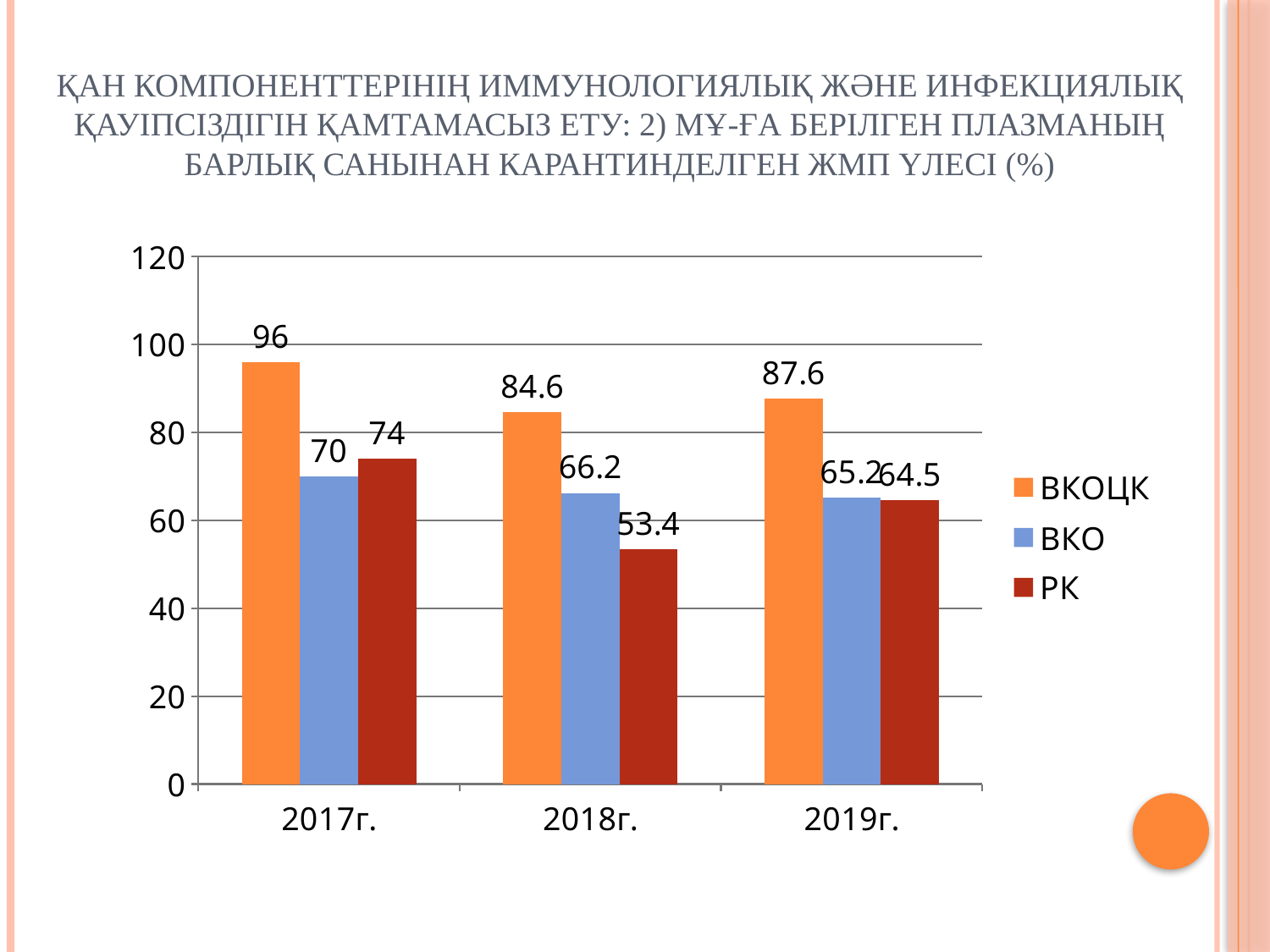
How many years are shown on the x axis? 3 What is the value for ВКОЦК in 2017г.? 96 What is the value for ВКОЦК in 2019г.? 87.6 Which is larger in 2017г., the ВКО value or the РК value? РК What is the value for ВКО in 2019г.? 65.2 Is the value for ВКОЦК in 2018г. greater or less than 80? greater In which year is the РК value lowest? 2018г. In which year is the ВКОЦК value highest? 2017г. What is the difference between the ВКОЦК and ВКО values in 2018г.? 18.4 What is the value for РК in 2018г.? 53.4 What kind of chart is shown on the slide? bar chart How many series does the legend list? 3